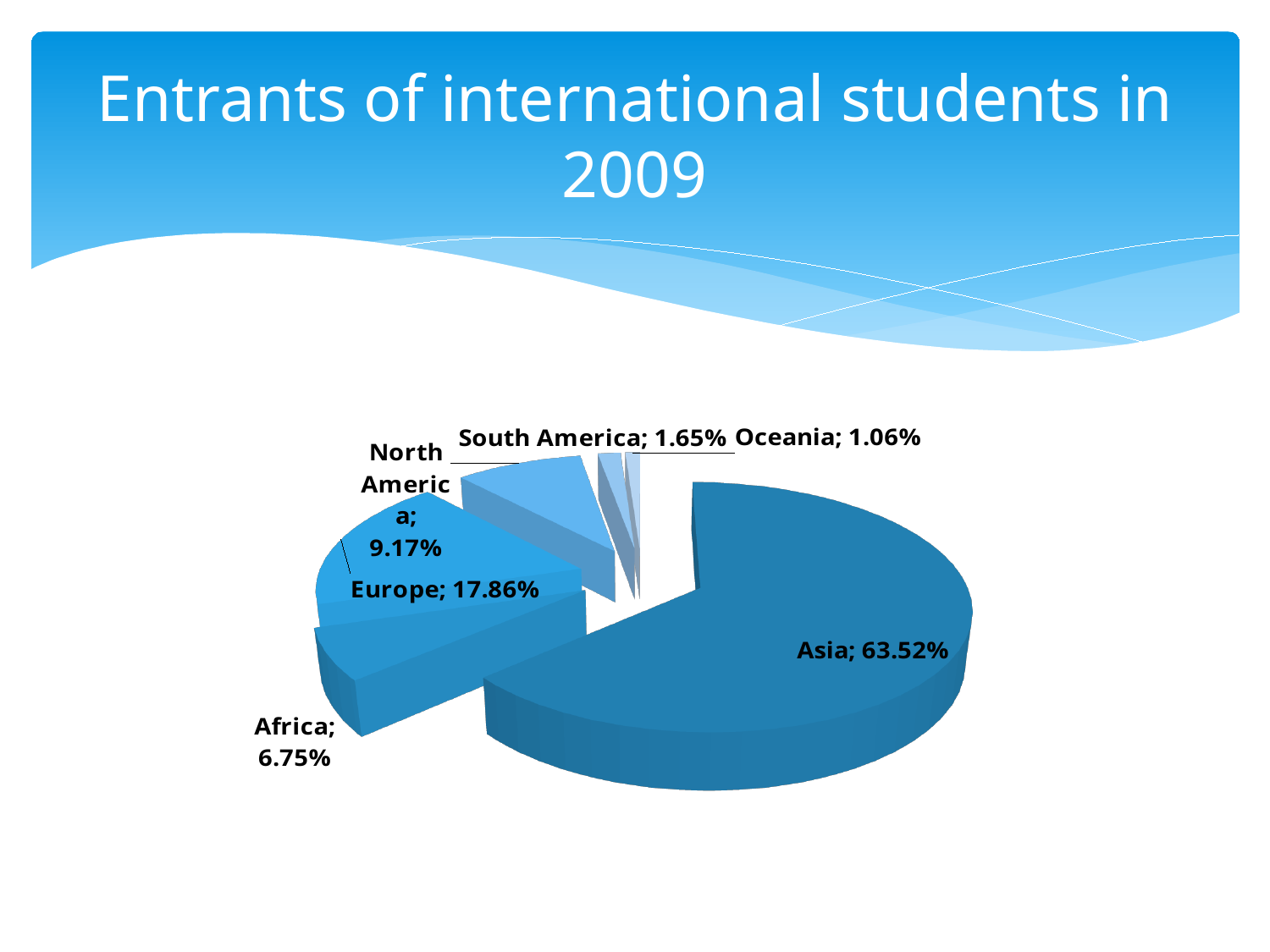
Which region has the largest share of international student entrants in 2009? Asia What share of international student entrants in 2009 came from Oceania? 1.06% Which region has a larger share of entrants, Africa or South America? Africa What share of international student entrants in 2009 came from Asia? 63.52% How many regions are shown in the pie chart? 6 Which region has the smallest share of international student entrants in 2009? Oceania What share of international student entrants in 2009 came from North America? 9.17% What is the difference in percentage points between the shares for Europe and North America? 8.69 What kind of chart is shown on the slide? Pie chart What is the title of the slide containing the chart? Entrants of international students in 2009 What share of international student entrants in 2009 came from Africa? 6.75% What share of international student entrants in 2009 came from Europe? 17.86%